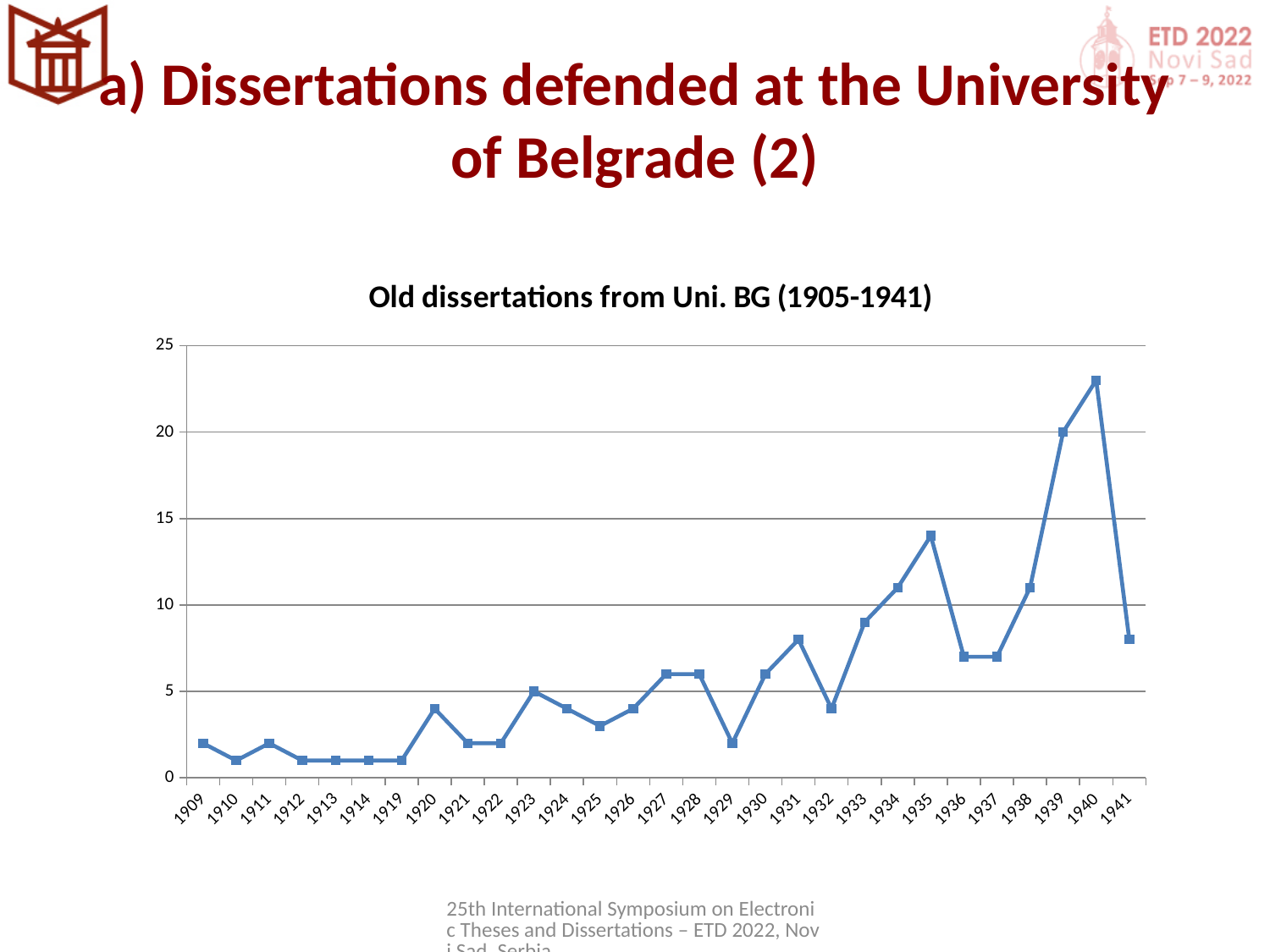
What kind of chart is shown on the slide? line chart Which year has the highest value in the chart? 1940 Is the value for 1935 greater or less than 10? greater What is the value for 1923? 5 What is the title of the chart? Old dissertations from Uni. BG (1905-1941) Which is larger, the value for 1939 or the value for 1935? 1939 Do the values generally rise or fall from 1909 to 1940? rise Is the value for 1929 greater or less than 5? less Is the value for 1940 greater or less than 20? greater What is the value for 1939? 20 How many years are plotted on the x axis? 29